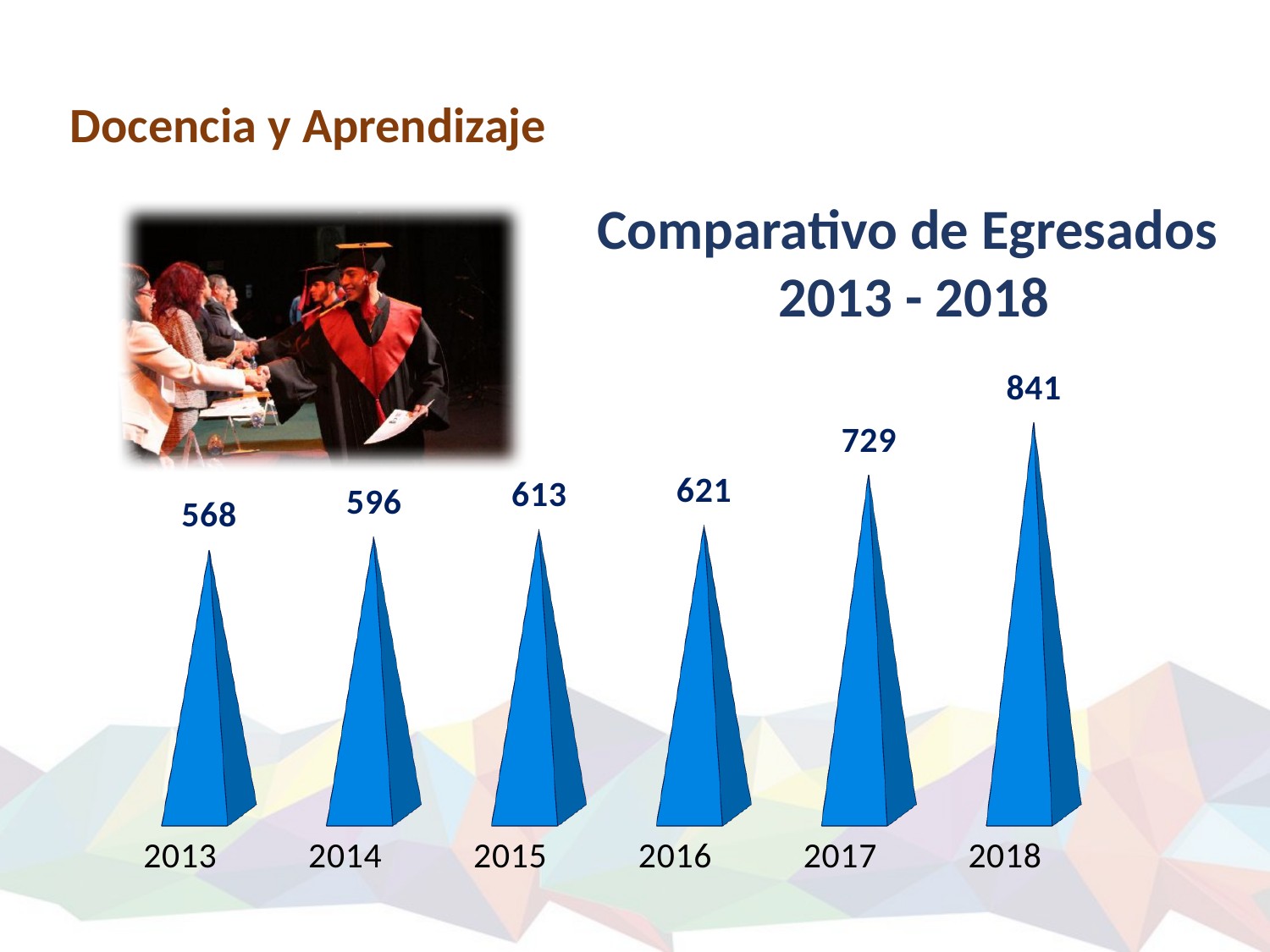
What is the difference between the values for 2018 and 2017? 112 Do the values rise or fall from 2013 to 2018? rise What is the difference between the values for 2014 and 2013? 28 Which year has the highest value? 2018 What is the value for 2013? 568 What is the value for 2018? 841 What is the value for 2016? 621 What is the title of the chart? Comparativo de Egresados 2013 - 2018 Which is larger, the value for 2015 or the value for 2017? 2017 Which year has the lowest value? 2013 How many years are shown on the chart? 6 What kind of chart is shown? bar chart